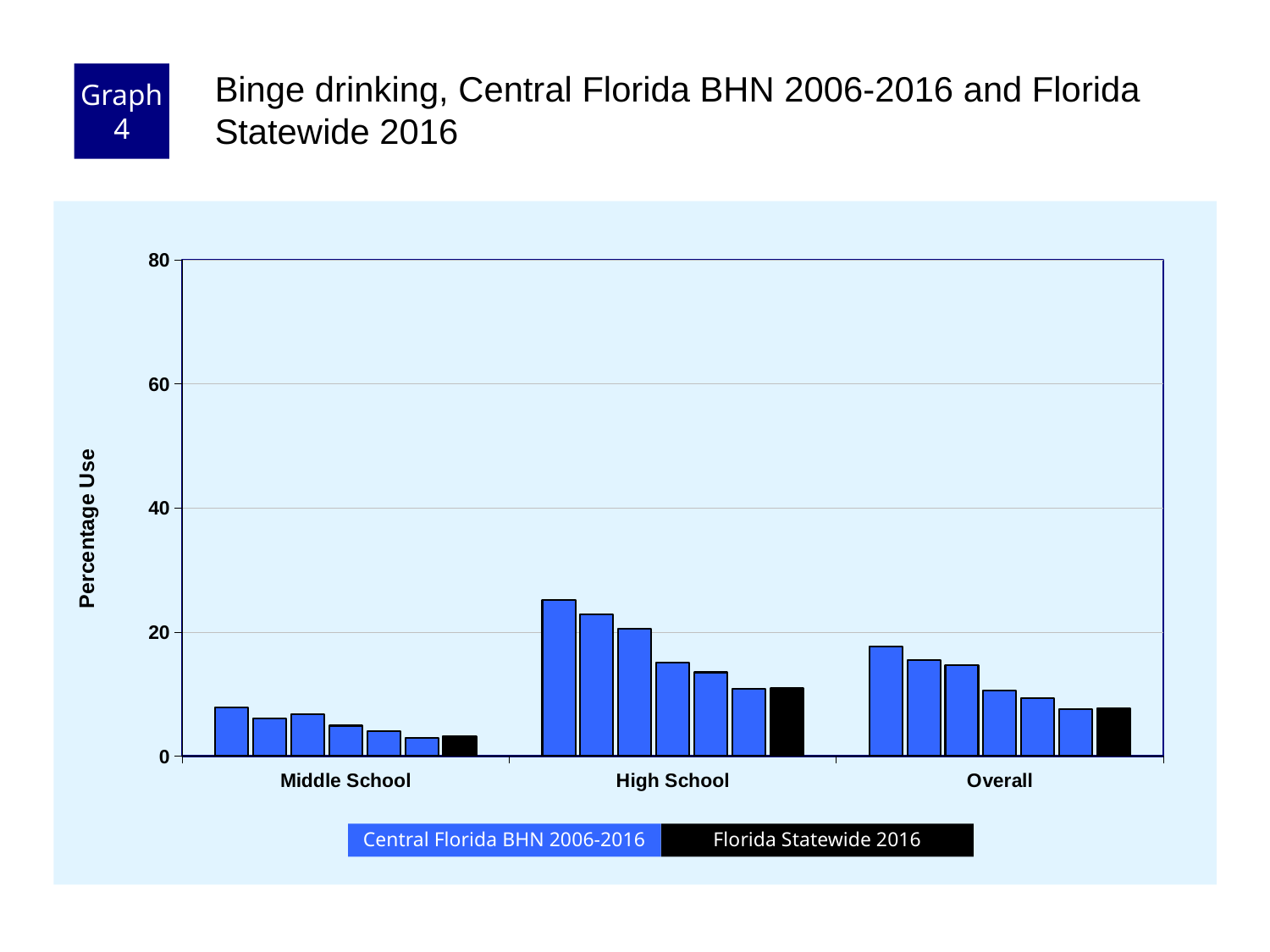
Within the High School group, do the Central Florida BHN bars rise or fall from 2006 to 2016? fall What kind of chart is shown on the slide? bar chart What is the label on the y axis? Percentage Use Which category has the lowest binge drinking percentages? Middle School Which category has the highest binge drinking percentages? High School Is the Florida Statewide 2016 value for High School greater or less than 20? less Is the tallest Central Florida BHN bar for High School greater or less than 20? greater How many series does the legend list? 2 How many school-level categories are shown on the x axis? 3 Which is larger, the Florida Statewide 2016 value for High School or for Middle School? High School Is the Florida Statewide 2016 value for Middle School greater or less than 20? less